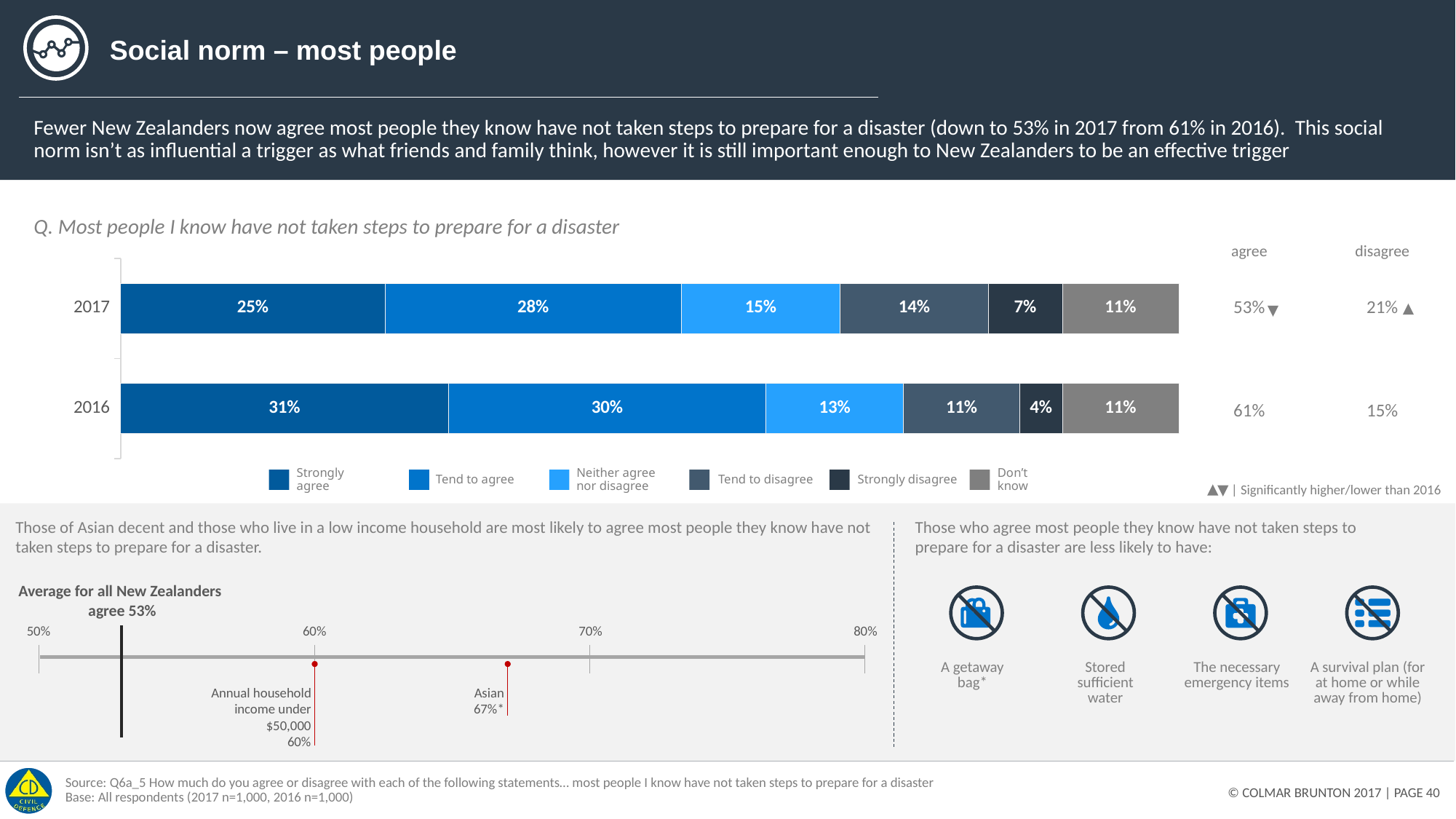
In the stacked bar chart, what percentage of respondents in 2017 said 'Strongly agree'? 25% According to the summary column next to the stacked bar chart, what is the total 'agree' percentage for 2017? 53% How many years (categories) are shown in the stacked bar chart? 2 What kind of chart is used to show the 2017 and 2016 responses? Stacked bar chart In the stacked bar chart, what percentage of respondents in 2016 said 'Tend to agree'? 30% In the stacked bar chart, what is the 'Don't know' value for 2016? 11% In the stacked bar chart, by how many percentage points did 'Strongly agree' fall from 2016 to 2017? 6 percentage points In the stacked bar chart, which year has the larger 'Neither agree nor disagree' share, 2017 or 2016? 2017 How many series does the legend of the stacked bar chart list? 6 In the dot plot at the bottom left, what is the agree percentage for Asian respondents? 67% In the dot plot at the bottom left, what is the agree percentage for those with annual household income under $50,000? 60% In the stacked bar chart, what is the 'Strongly disagree' value for 2017? 7%